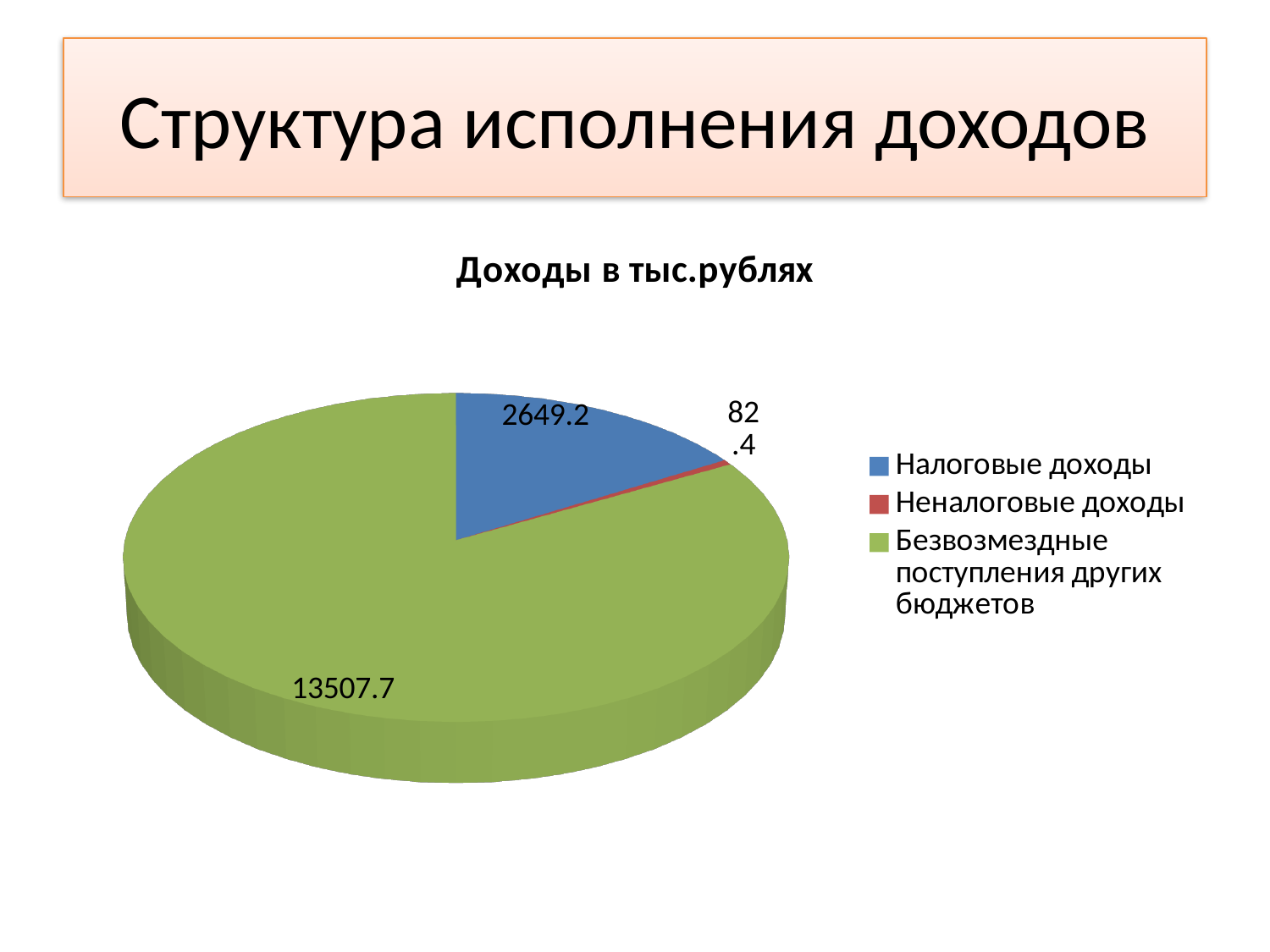
How many categories does the pie chart show? 3 What type of chart is shown on the slide? Pie chart What is the difference between Безвозмездные поступления других бюджетов and Налоговые доходы? 10858.5 What is the value for Безвозмездные поступления других бюджетов? 13507.7 What is the value for Неналоговые доходы? 82.4 What is the difference between Налоговые доходы and Неналоговые доходы? 2566.8 Which is larger, Налоговые доходы or Неналоговые доходы? Налоговые доходы What is the total of all slices in the pie chart? 16239.3 Which category has the smallest slice of the pie? Неналоговые доходы Which category has the largest slice of the pie? Безвозмездные поступления других бюджетов What is the title of the chart? Доходы в тыс.рублях What is the value for Налоговые доходы? 2649.2